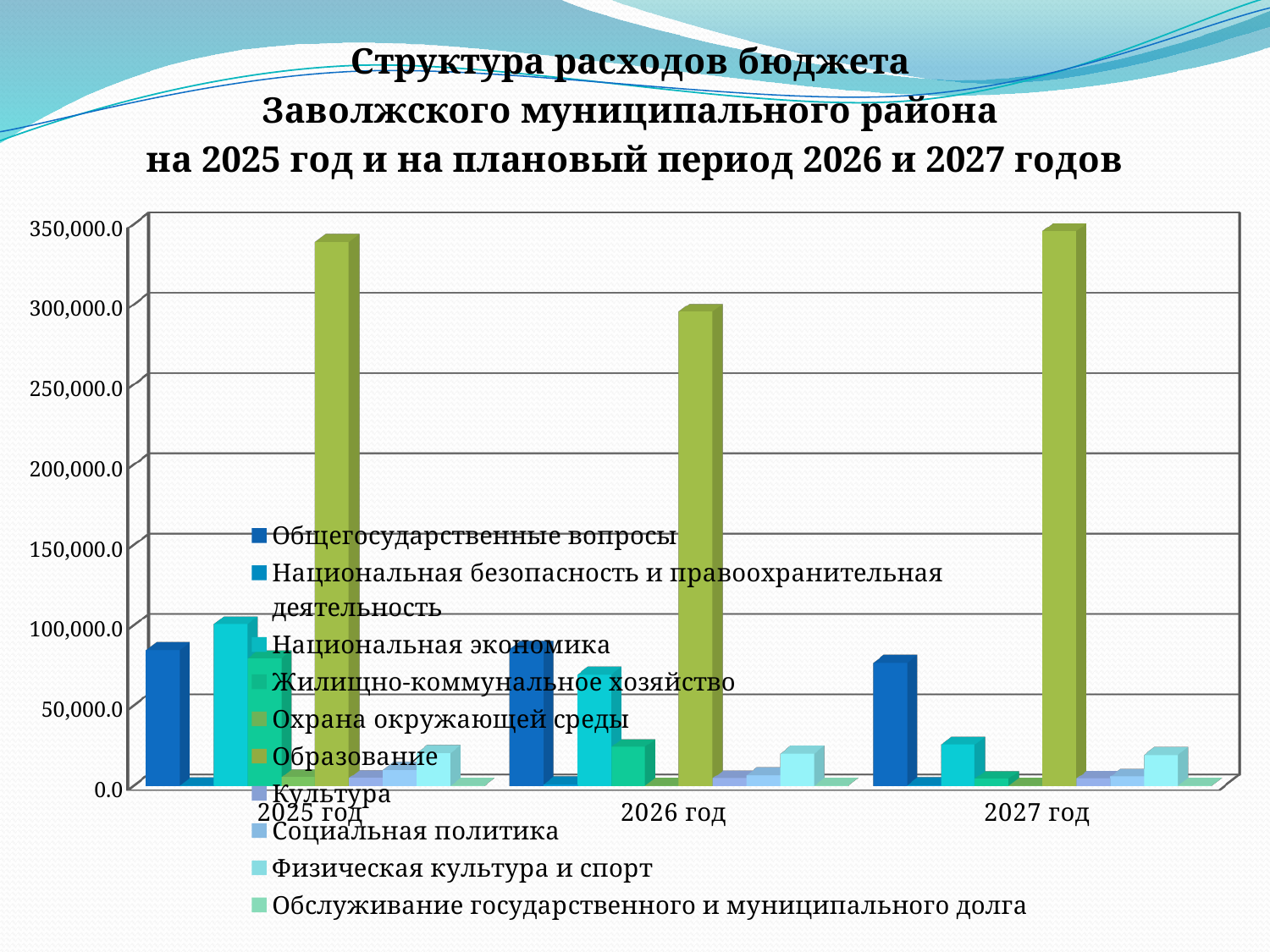
Is the value for Образование in 2026 год greater or less than 250,000.0? greater Which is larger: the Образование bar for 2025 год or for 2026 год? 2025 год Which expenditure series has the highest bar in 2025 год? Образование How many year categories are shown on the x axis? 3 Which series is listed last in the legend? Обслуживание государственного и муниципального долга What kind of chart is shown on the slide? bar chart Which expenditure series has the highest bar in 2026 год? Образование Is the value for Национальная экономика in 2027 год greater or less than 50,000.0? less Is the value for Общегосударственные вопросы in 2025 год greater or less than 100,000.0? less How many series does the legend list? 10 In which year is the bar for Образование the lowest? 2026 год